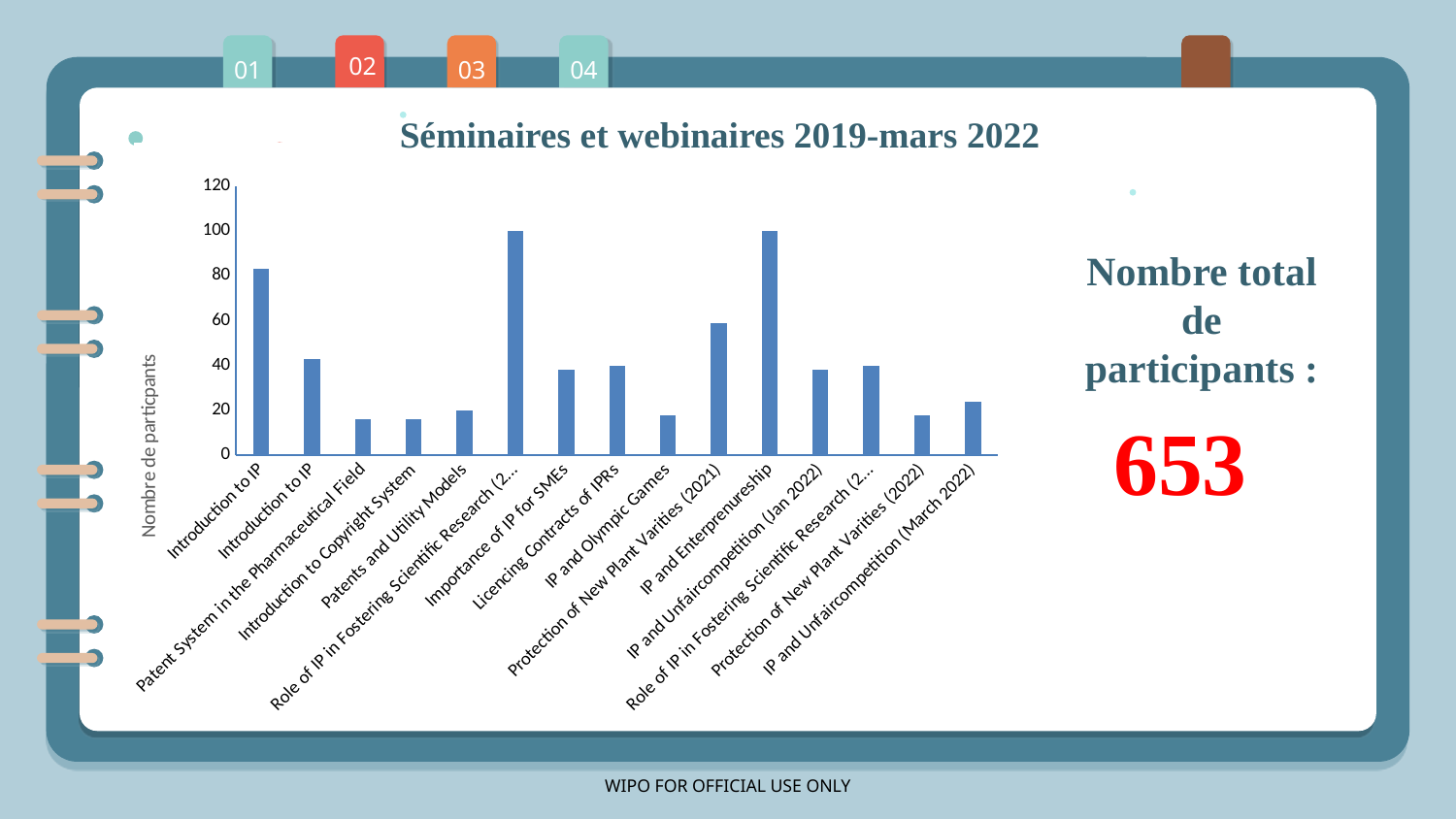
What kind of chart is shown on the slide? bar chart What is the label on the vertical axis of the chart? Nombre de particpants What is the title of the chart? Séminaires et webinaires 2019-mars 2022 Is the value for Introduction to Copyright System greater or less than 20? less Is the value for Protection of New Plant Varities (2021) greater or less than 40? greater Is the value for IP and Enterprenureship greater or less than 80? greater Which has more participants, Protection of New Plant Varities (2021) or Protection of New Plant Varities (2022)? Protection of New Plant Varities (2021) How many bars (seminars/webinars) are plotted in the chart? 15 Which has more participants, IP and Enterprenureship or Patents and Utility Models? IP and Enterprenureship